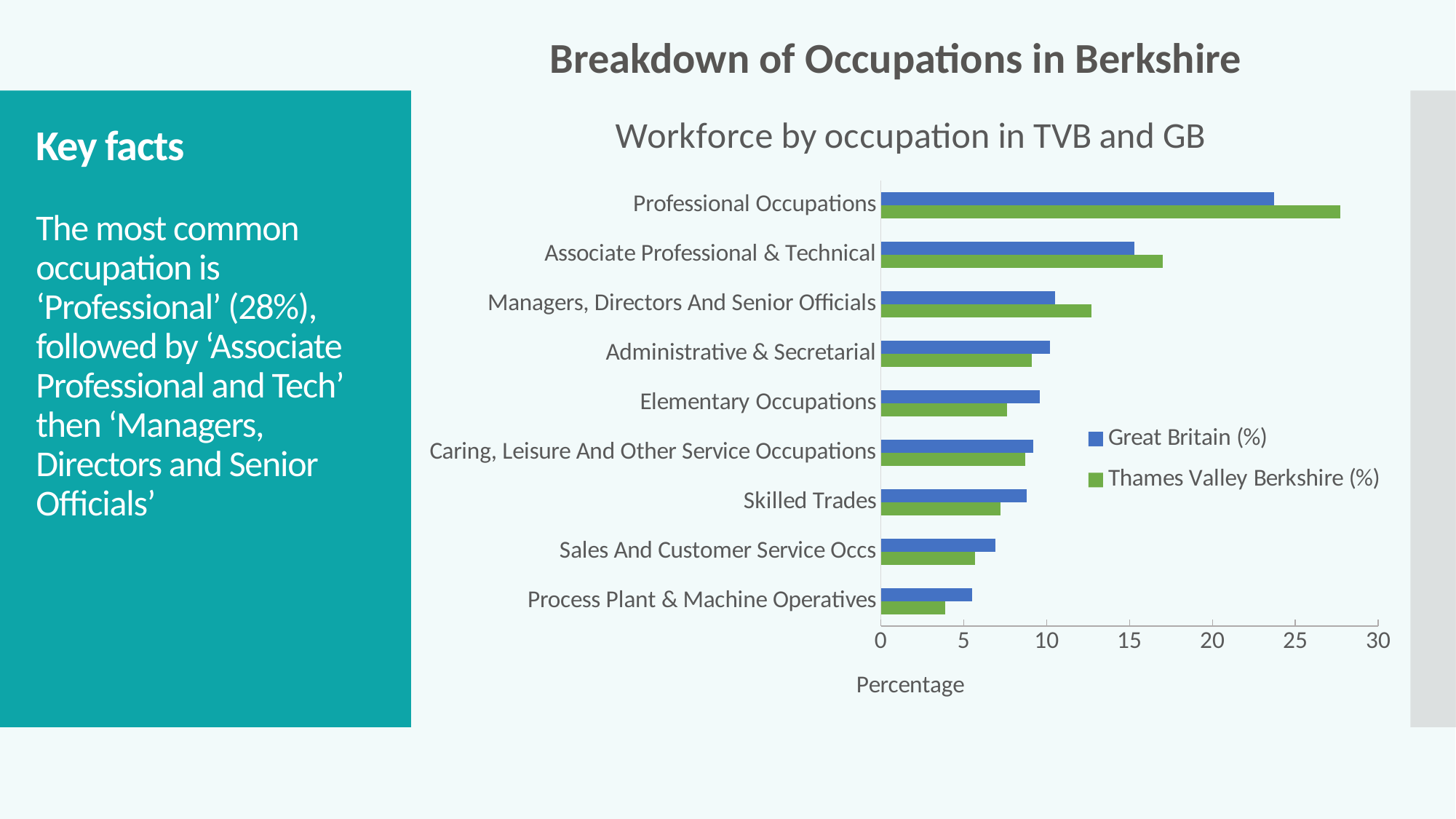
Is the Thames Valley Berkshire (%) value for Process Plant & Machine Operatives greater or less than 5? less Which occupation category has the highest Thames Valley Berkshire (%) value? Professional Occupations For Elementary Occupations, which is larger: the Great Britain (%) value or the Thames Valley Berkshire (%) value? Great Britain (%) What is the title of the chart? Workforce by occupation in TVB and GB How many series does the chart's legend list? 2 How many occupation categories are plotted in the chart? 9 Which occupation category has the lowest Great Britain (%) value? Process Plant & Machine Operatives Is the Thames Valley Berkshire (%) value for Professional Occupations greater or less than 25? greater For Professional Occupations, which is larger: the Great Britain (%) value or the Thames Valley Berkshire (%) value? Thames Valley Berkshire (%) Is the Great Britain (%) value for Professional Occupations greater or less than 25? less What kind of chart is shown on the slide? Bar chart